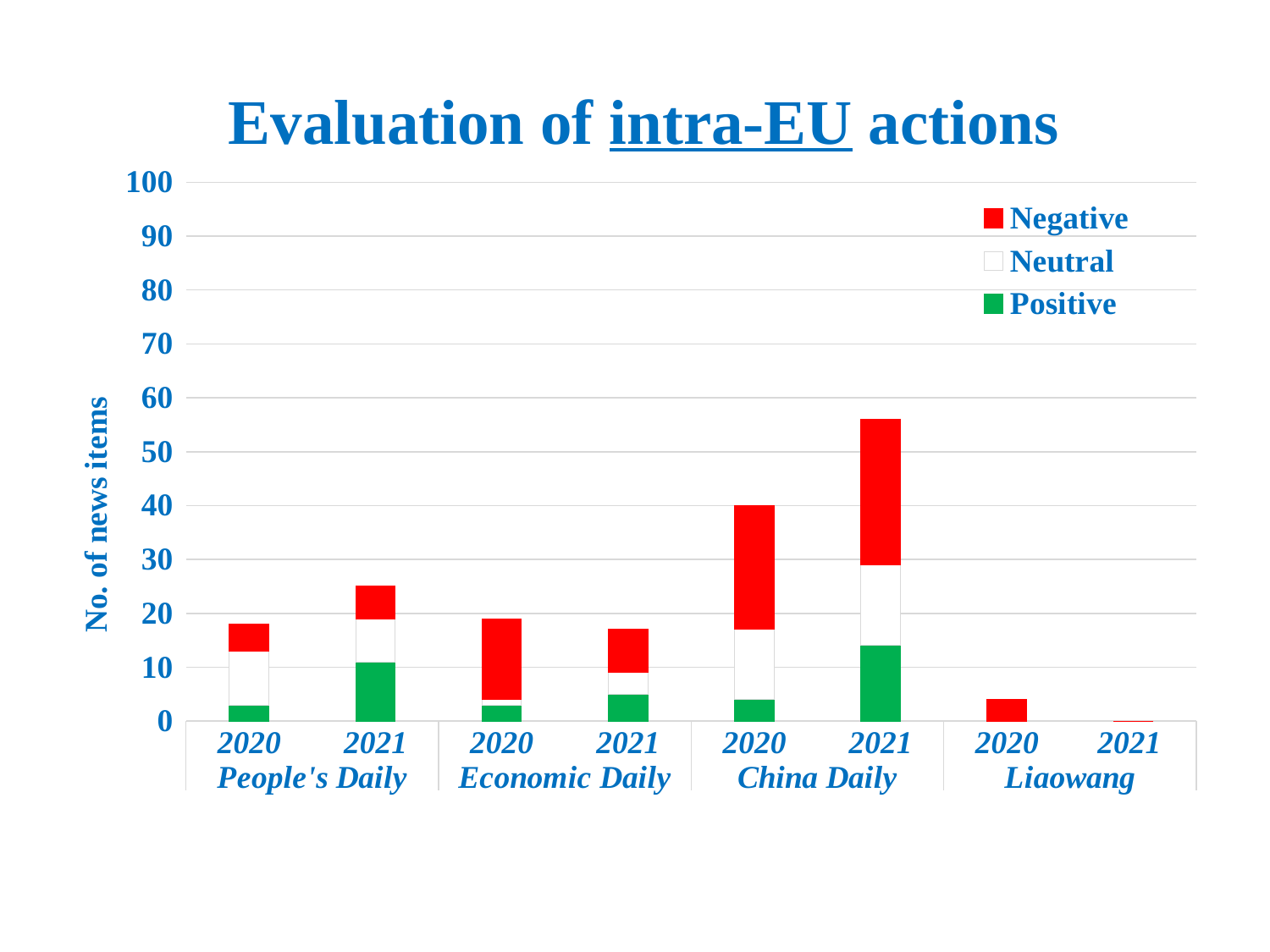
Is the total for China Daily 2020 greater or less than 30? greater Is the total for People's Daily 2021 greater or less than 20? greater Which bar has the lowest total number of news items? Liaowang 2021 What kind of chart is shown on the slide? Stacked bar chart Which has a larger total, China Daily 2020 or People's Daily 2020? China Daily 2020 Is the total for China Daily 2021 greater or less than 50? greater How many bars are plotted in the chart? 8 Which bar has the highest total number of news items? China Daily 2021 How many series does the legend list? 3 What is the title of the chart? Evaluation of intra-EU actions What is the label on the vertical axis? No. of news items